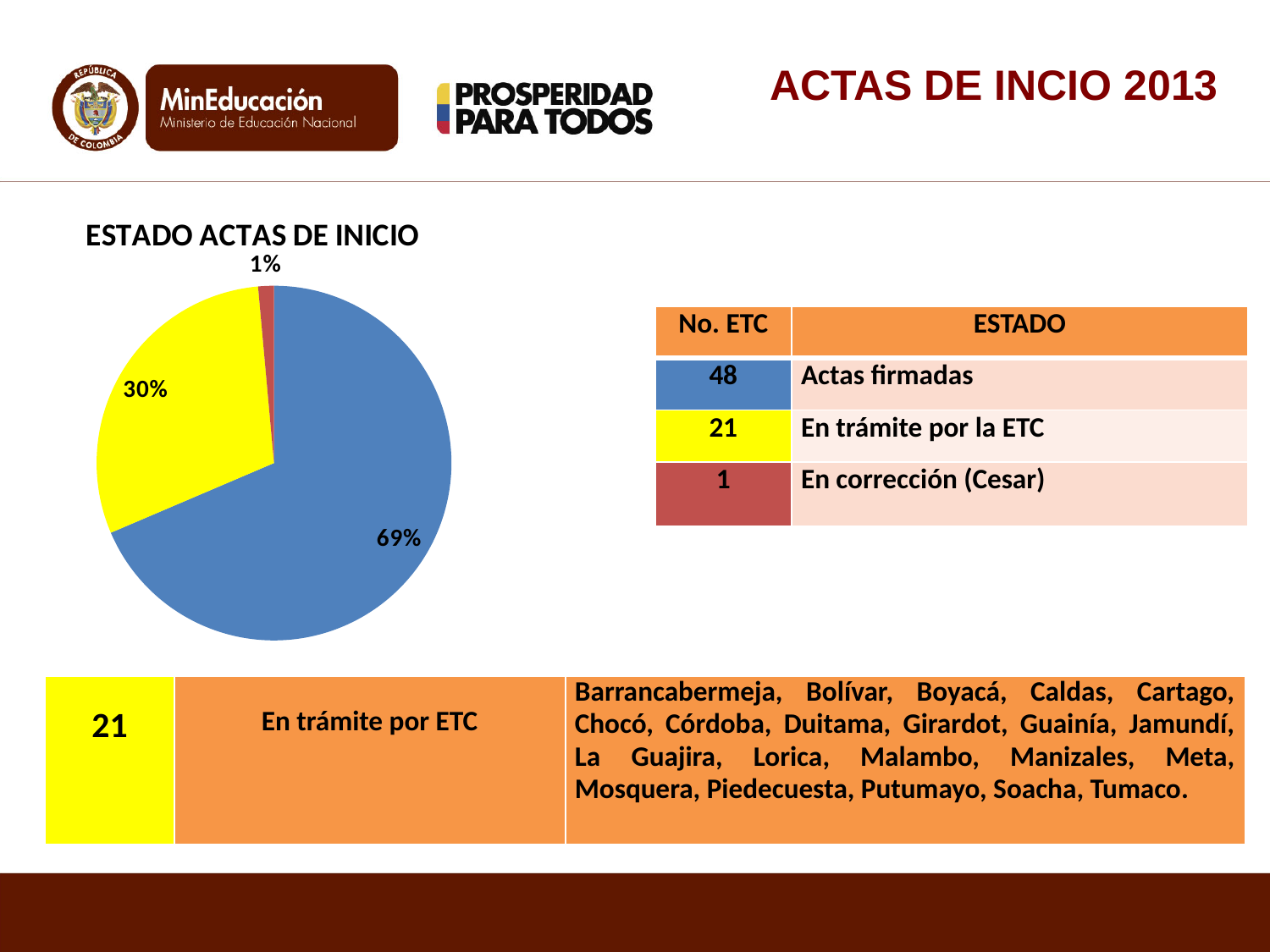
Which slice is larger, the yellow slice or the red slice? the yellow slice What percentage is shown on the yellow slice of the pie chart? 30% What share of the pie does the blue slice (Actas firmadas) represent? 69% What percentage is shown on the smallest slice of the pie chart? 1% What percentage is shown on the largest slice of the pie chart? 69% What is the difference in percentage points between the blue slice (69%) and the yellow slice (30%)? 39 What kind of chart is shown on the slide? pie chart Is the share of the yellow slice greater or less than 50%? less What is the title of the pie chart? ESTADO ACTAS DE INICIO Which colour is used for the largest slice of the pie chart? blue How many slices does the pie chart have? 3 What share of the pie does the red slice (En corrección) represent? 1%